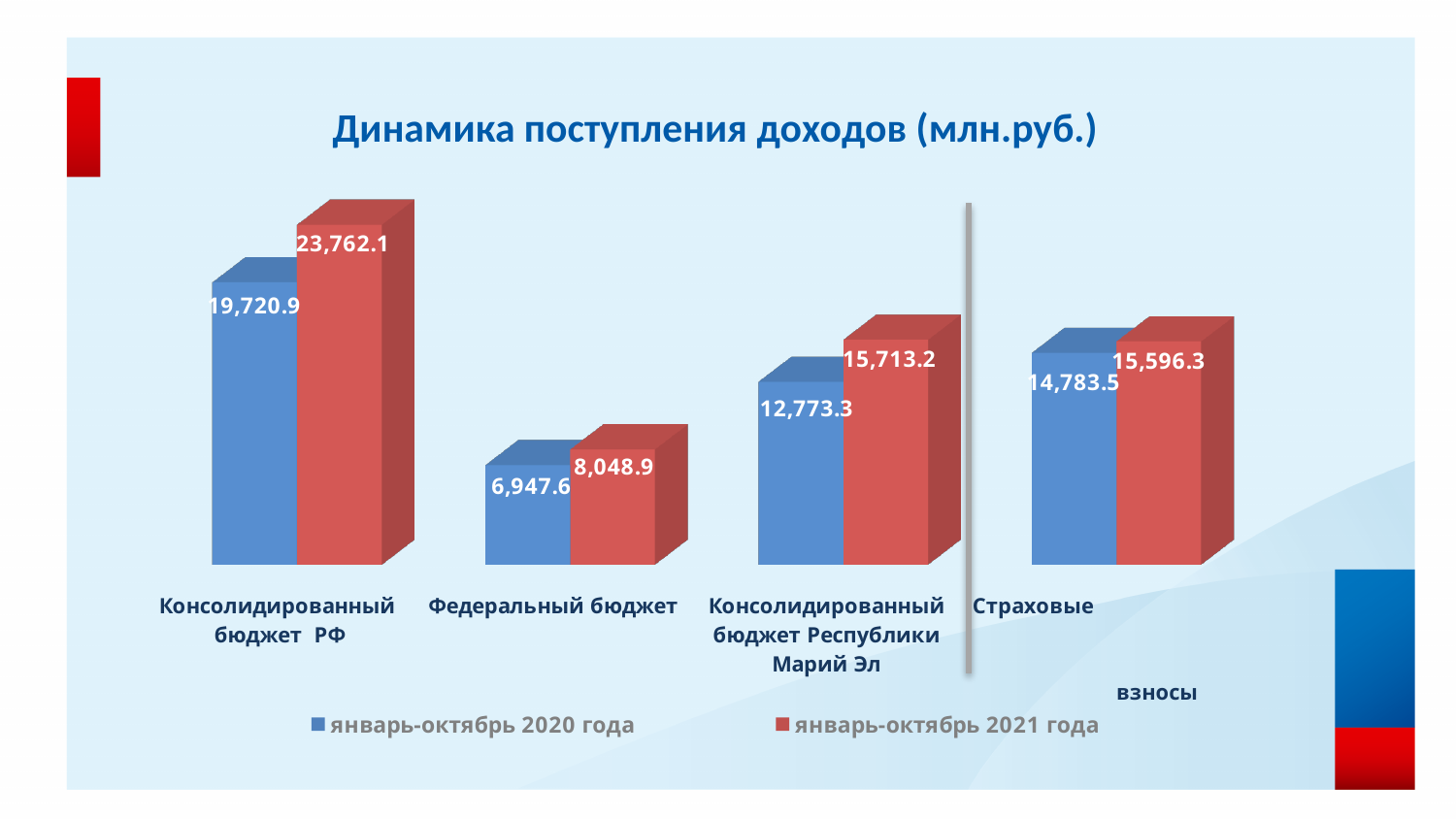
How many categories are shown on the x axis? 4 How many series does the legend list? 2 What is the value for Федеральный бюджет in the январь-октябрь 2020 года series? 6,947.6 What is the difference between the 2021 and 2020 values for Консолидированный бюджет Республики Марий Эл? 2,939.9 What is the value for Консолидированный бюджет Республики Марий Эл in the январь-октябрь 2020 года series? 12,773.3 What is the difference between the 2021 and 2020 values for Консолидированный бюджет РФ? 4,041.2 What is the value for Страховые взносы in the январь-октябрь 2021 года series? 15,596.3 Which category has the highest value in the январь-октябрь 2021 года series? Консолидированный бюджет РФ What kind of chart is shown on the slide? Bar chart What is the value for Консолидированный бюджет РФ in the январь-октябрь 2021 года series? 23,762.1 Which category has the lowest value in the январь-октябрь 2020 года series? Федеральный бюджет Which is larger for Страховые взносы: the январь-октябрь 2020 года value or the январь-октябрь 2021 года value? январь-октябрь 2021 года